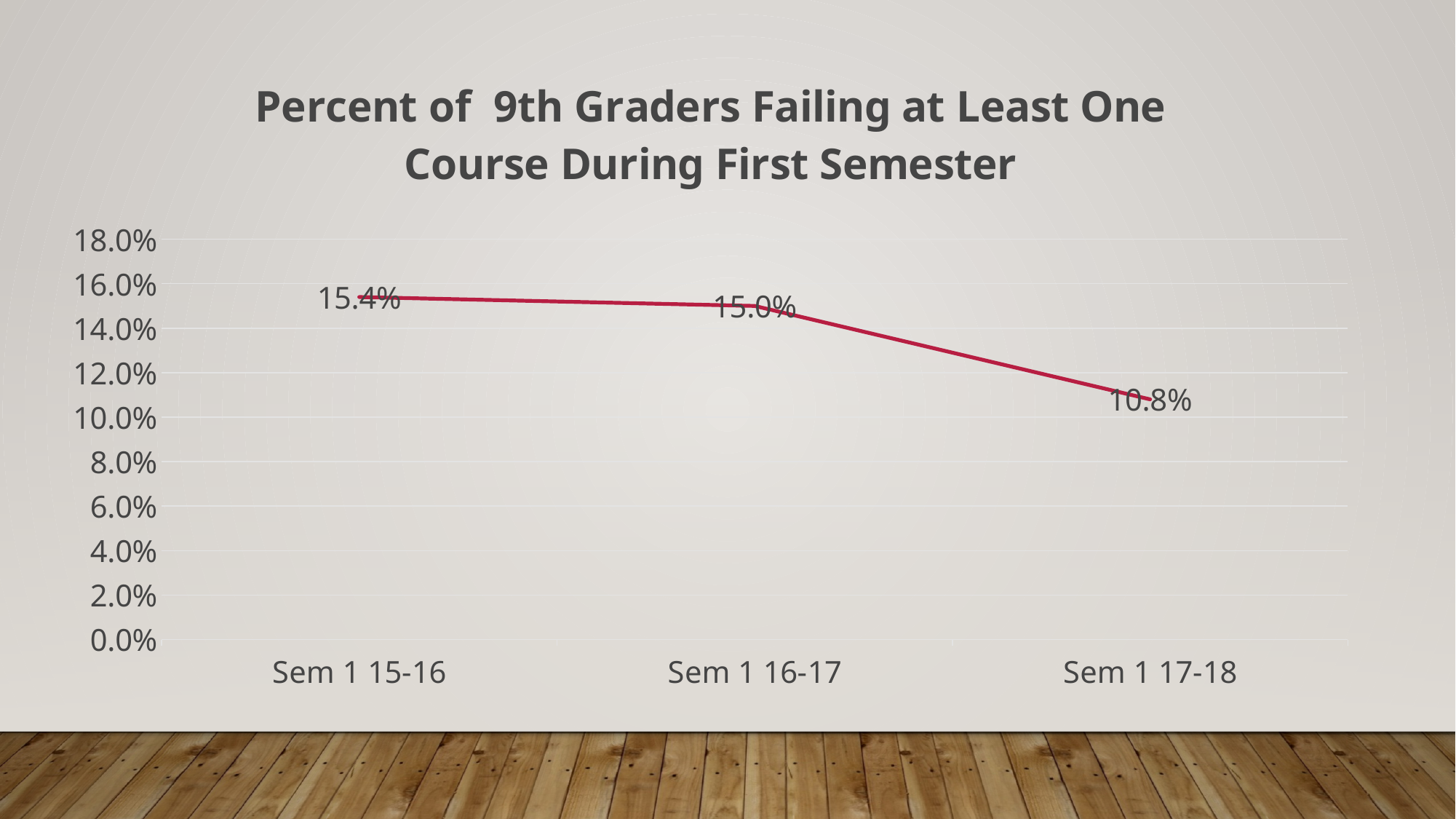
Do the values rise or fall from Sem 1 15-16 to Sem 1 17-18? Fall How many data points are plotted on the chart? 3 Which semester has the lowest percentage of 9th graders failing at least one course? Sem 1 17-18 Which is larger, the value for Sem 1 16-17 or the value for Sem 1 17-18? Sem 1 16-17 What is the value for Sem 1 16-17? 15.0% What kind of chart is shown on the slide? Line chart What is the difference between the values for Sem 1 15-16 and Sem 1 17-18? 4.6% Which semester has the highest percentage of 9th graders failing at least one course? Sem 1 15-16 What is the difference between the values for Sem 1 16-17 and Sem 1 17-18? 4.2% Is the value for Sem 1 17-18 greater or less than 12.0%? less What is the value for Sem 1 17-18? 10.8% What is the value for Sem 1 15-16? 15.4%